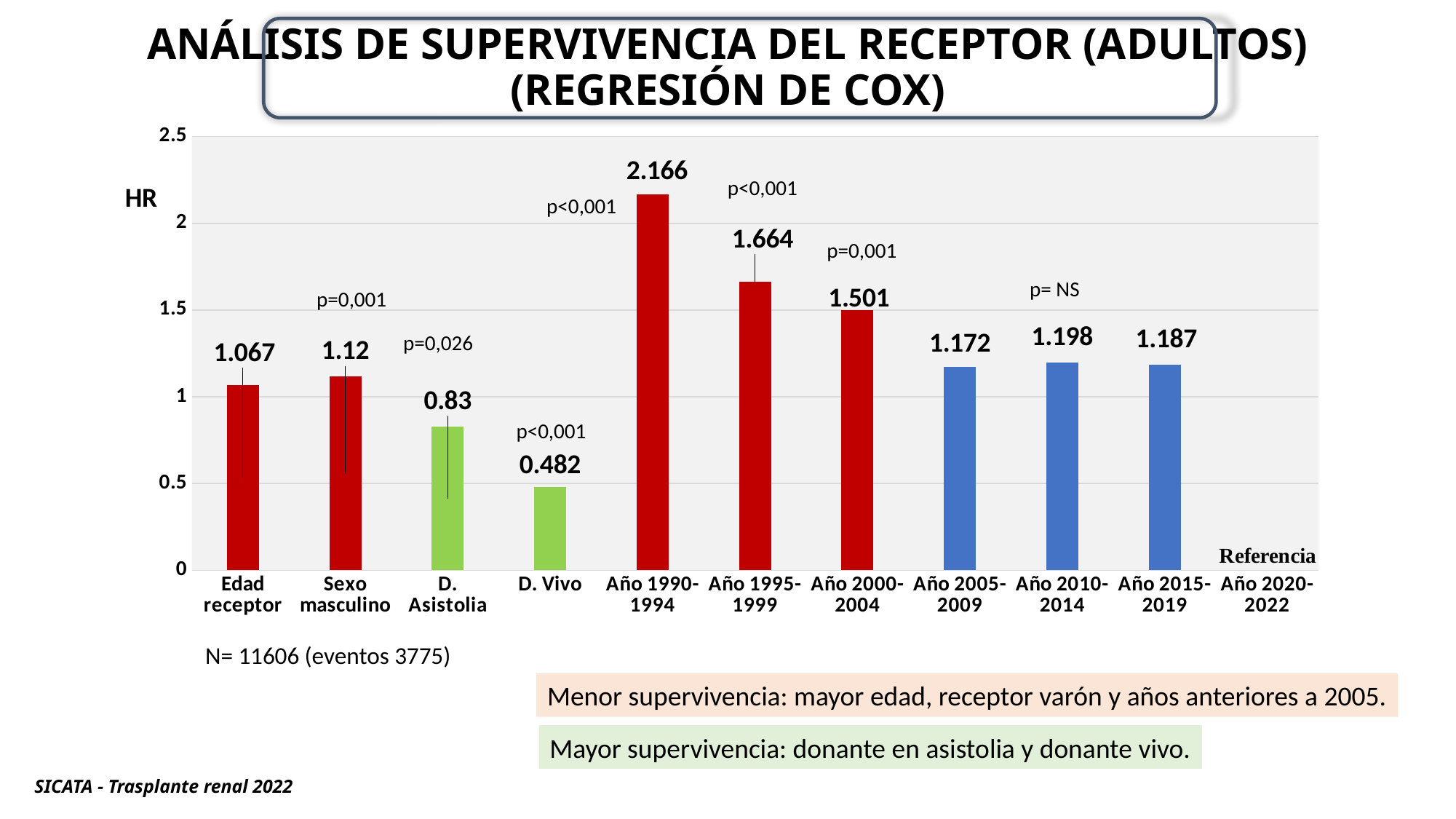
How many bars are plotted in the chart? 10 Which category has the lowest HR value? D. Vivo What is the HR value for Año 2010-2014? 1.198 Which has a larger HR value, Año 2000-2004 or Año 2005-2009? Año 2000-2004 What is the difference between the HR values for Año 1990-1994 and Año 1995-1999? 0.502 Which category has the highest HR value? Año 1990-1994 Which category is labelled as the reference (Referencia) with no bar? Año 2020-2022 What is the HR value for Sexo masculino? 1.12 What is the HR value for D. Vivo? 0.482 What is the HR value for Año 1990-1994? 2.166 What kind of chart is shown on the slide? Bar chart Is the HR value for D. Asistolia greater or less than 1? less